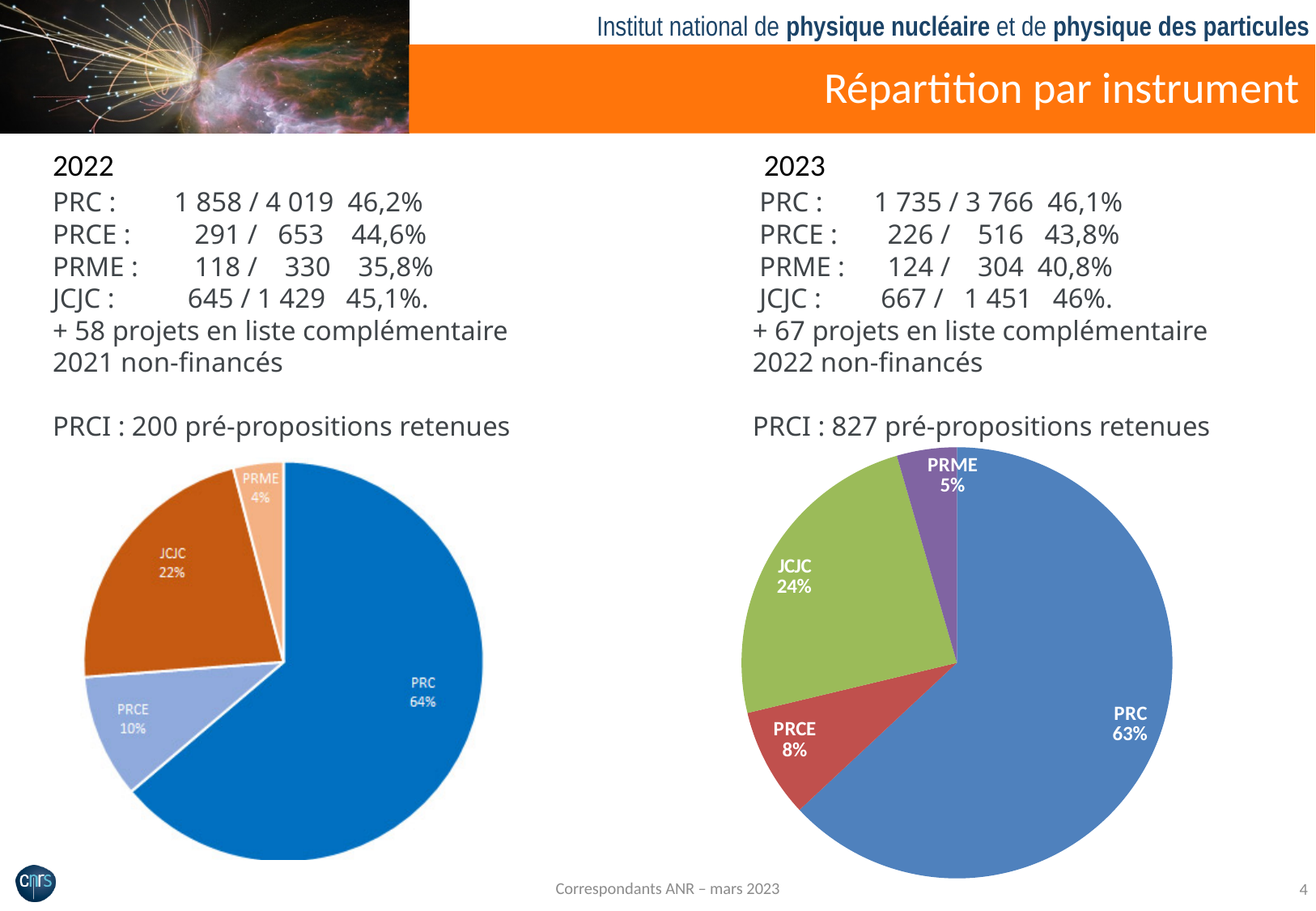
In the right pie chart (2023), which is larger, the JCJC slice or the PRCE slice? JCJC In the right pie chart (2023), which category has the largest slice? PRC In the left pie chart (2022), what share does PRC have? 64% In the right pie chart (2023), what share does PRME have? 5% What type of chart is shown on the left side of the slide? Pie chart In the right pie chart (2023), what share does PRCE have? 8% In the left pie chart (2022), what is the difference between the PRC share and the JCJC share? 42% In the left pie chart (2022), which category has the smallest slice? PRME How many slices does the right pie chart (2023) have? 4